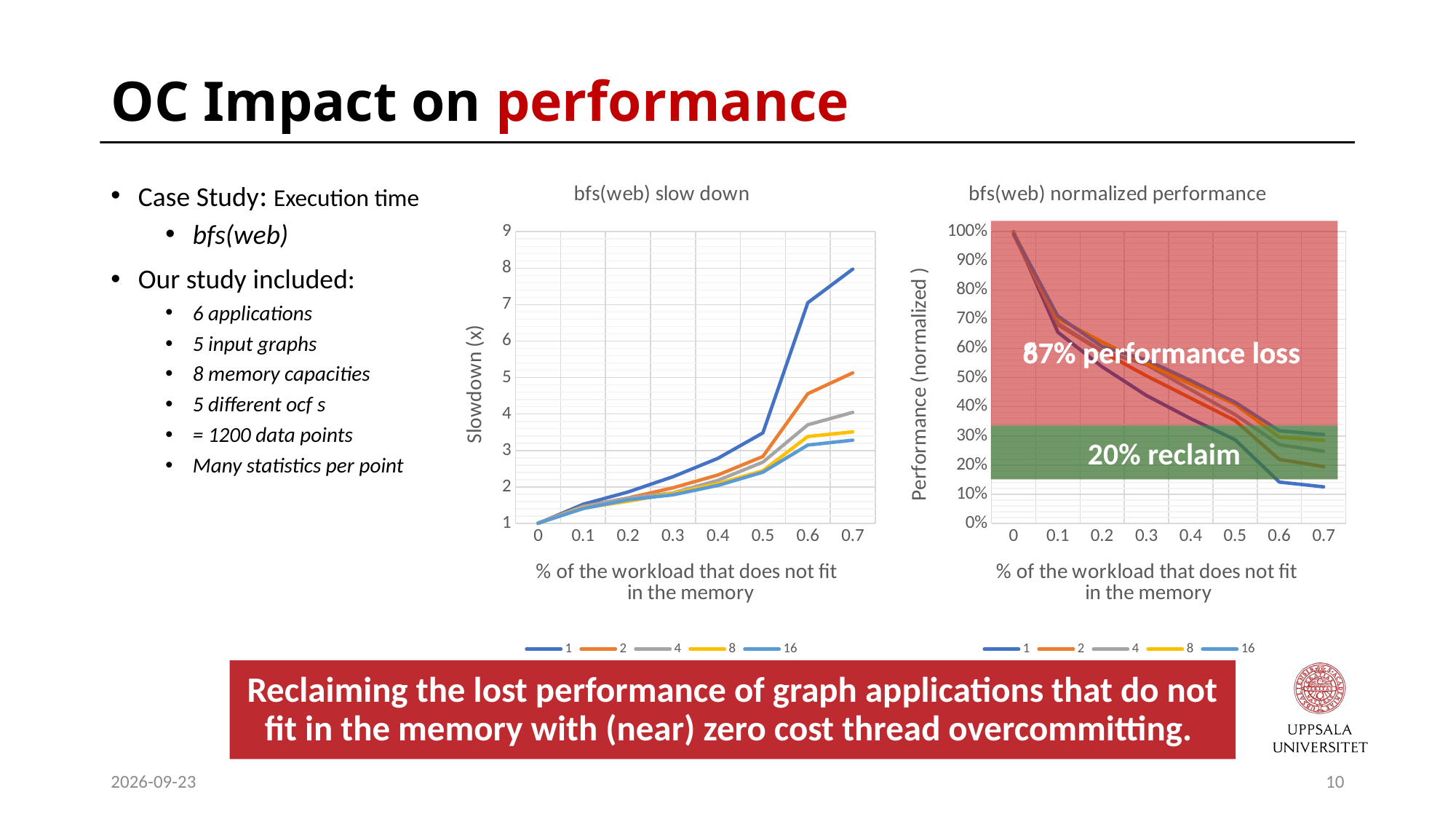
In the 'bfs(web) normalized performance' chart, what is the performance value for series 1 at x = 0? 100% In the 'bfs(web) normalized performance' chart, is the value for series 1 at x = 0.7 greater or less than 20%? less What type of chart is the 'bfs(web) slow down' chart? line chart What performance loss percentage is annotated in the red region of the 'bfs(web) normalized performance' chart? 87% How many series does the legend of the 'bfs(web) slow down' chart list? 5 In the 'bfs(web) slow down' chart, which series has the highest slowdown at x = 0.7? 1 In the 'bfs(web) normalized performance' chart, do the values rise or fall as x increases from 0 to 0.7? fall In the 'bfs(web) slow down' chart, is the slowdown for series 1 at x = 0.7 greater or less than 7? greater In the 'bfs(web) slow down' chart, what is the slowdown value for series 1 at x = 0? 1 How many x-axis points are plotted on the 'bfs(web) normalized performance' chart? 8 In the 'bfs(web) slow down' chart, is the slowdown for series 16 at x = 0.7 greater or less than 4? less In the 'bfs(web) slow down' chart, which series has the lowest slowdown at x = 0.7? 16